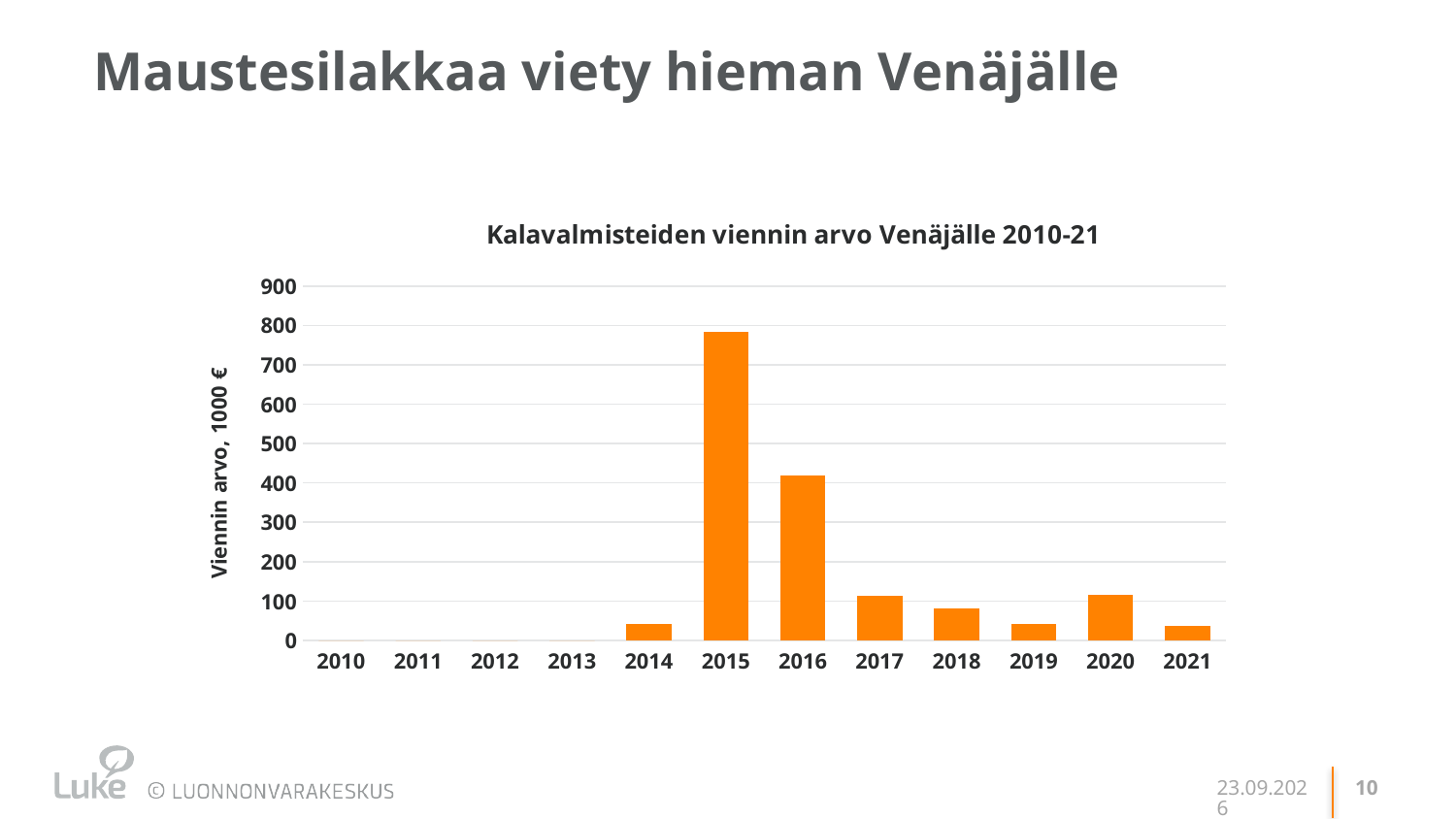
What is the label of the y axis? Viennin arvo, 1000 € Which year has the larger value, 2015 or 2016? 2015 Is the value for 2017 greater or less than 200? less Is the value for 2021 greater or less than 100? less Which year has the larger value, 2016 or 2017? 2016 How many years are shown on the x axis of the chart? 12 What kind of chart is shown on the slide? bar chart Is the value for 2016 greater or less than 300? greater Which year has the highest export value in the chart? 2015 What is the title of the chart? Kalavalmisteiden viennin arvo Venäjälle 2010-21